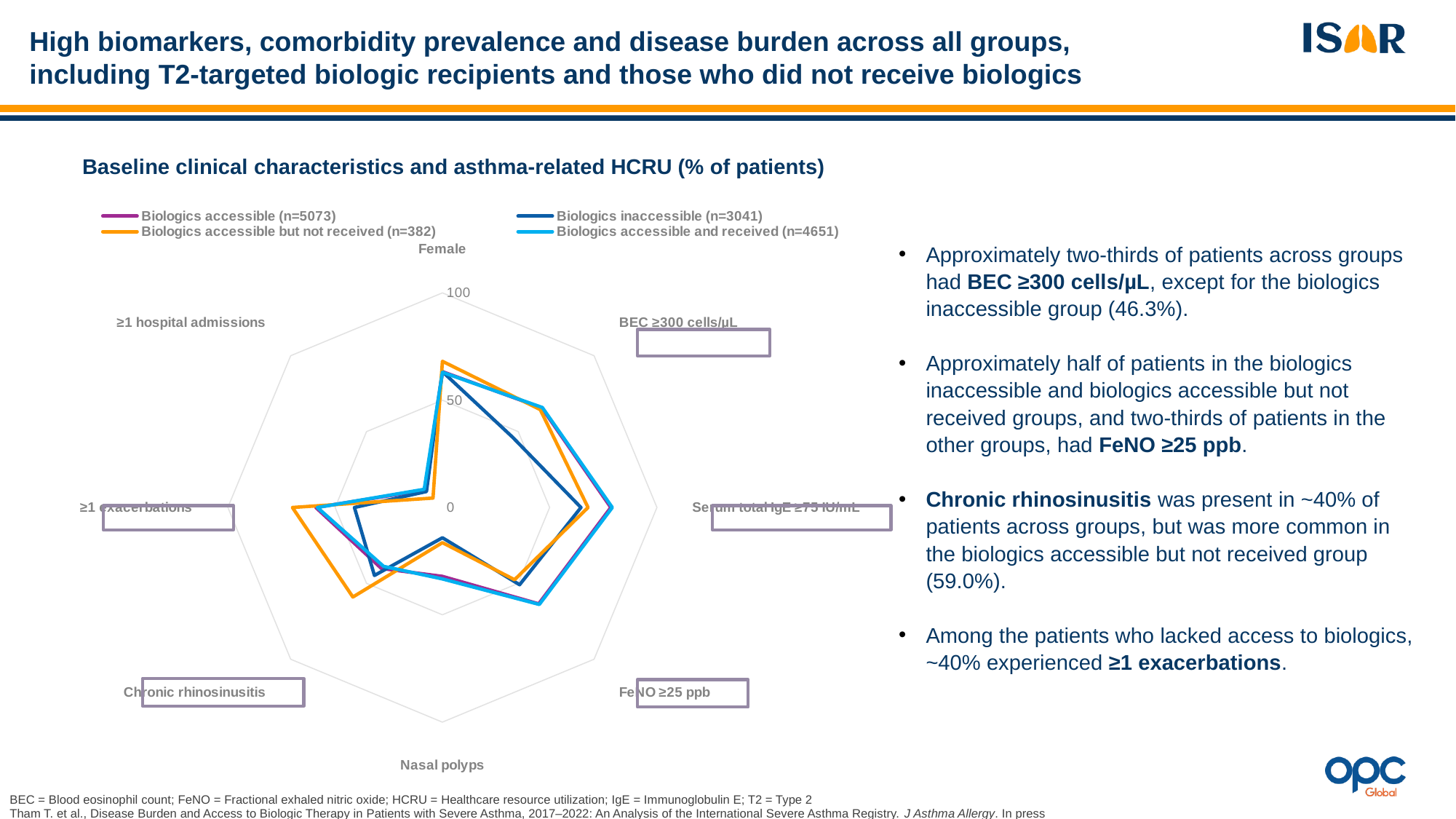
How many categories (axes) does the radar chart have? 8 What is the title of the chart? Baseline clinical characteristics and asthma-related HCRU (% of patients) Which legend entry is shown in orange? Biologics accessible but not received (n=382) Which category has the lowest values across all groups? ≥1 hospital admissions Is the value for Female in the Biologics accessible and received (n=4651) group greater or less than 50? greater What kind of chart is shown on the slide? Radar chart Is the value for ≥1 exacerbations in the Biologics accessible but not received (n=382) group greater or less than 50? greater For ≥1 exacerbations, which group has the larger value: Biologics accessible but not received (n=382) or Biologics inaccessible (n=3041)? Biologics accessible but not received (n=382) For BEC ≥300 cells/µL, which group has the larger value: Biologics accessible and received (n=4651) or Biologics inaccessible (n=3041)? Biologics accessible and received (n=4651) Is the value for Nasal polyps in the Biologics accessible but not received (n=382) group greater or less than 50? less How many series does the legend list? 4